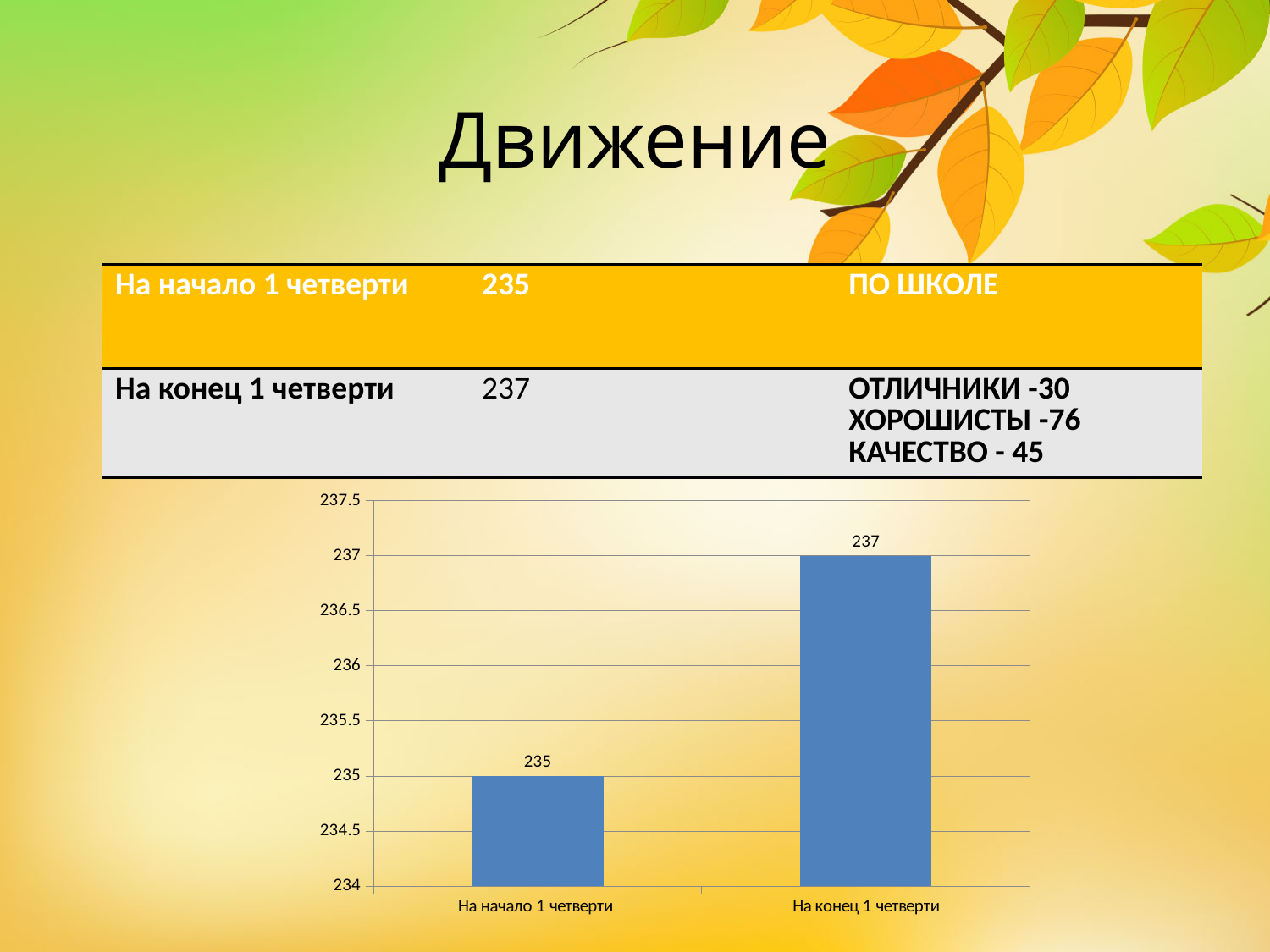
Which is larger: the value for "На начало 1 четверти" or "На конец 1 четверти"? На конец 1 четверти What kind of chart is shown on the slide? bar chart Do the values rise or fall from left to right along the x axis? rise What is the difference between the values for "На конец 1 четверти" and "На начало 1 четверти"? 2 Is the value for "На конец 1 четверти" greater or less than 236? greater Which category has the highest value? На конец 1 четверти How many categories are shown on the chart? 2 What is the value for "На конец 1 четверти"? 237 Which category has the lowest value? На начало 1 четверти Is the value for "На начало 1 четверти" greater or less than 236? less What is the title of the slide containing the chart? Движение What is the value for "На начало 1 четверти"? 235